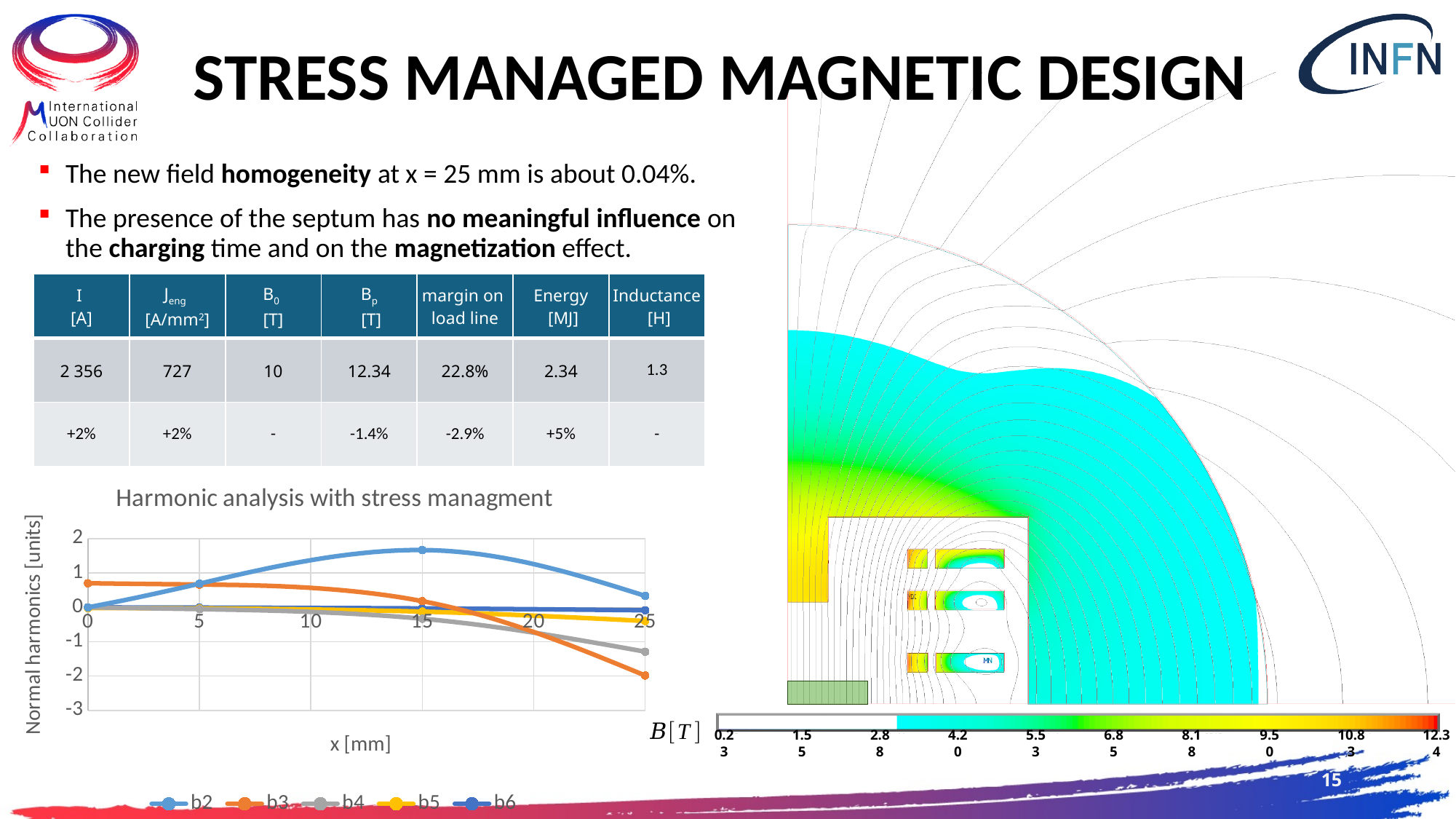
What is the title of the chart on the slide? Harmonic analysis with stress managment In the harmonic analysis chart, is the value of b2 at x = 15 greater or less than 1? greater In the harmonic analysis chart, does the b3 series rise or fall from x = 5 to x = 25? fall How many tick values are labelled on the x axis of the harmonic analysis chart? 6 How many series does the legend of the harmonic analysis chart list? 5 In the harmonic analysis chart, which series has the lowest value at x = 25? b3 What is the x-axis label of the harmonic analysis chart? x [mm] What kind of chart is 'Harmonic analysis with stress managment'? line chart In the harmonic analysis chart, is the value of b4 at x = 25 greater or less than -1? less In the harmonic analysis chart, at x = 25, which is larger: b2 or b3? b2 In the harmonic analysis chart, is the value of b3 at x = 25 greater or less than -1? less In the harmonic analysis chart, which series has the highest value at x = 15? b2